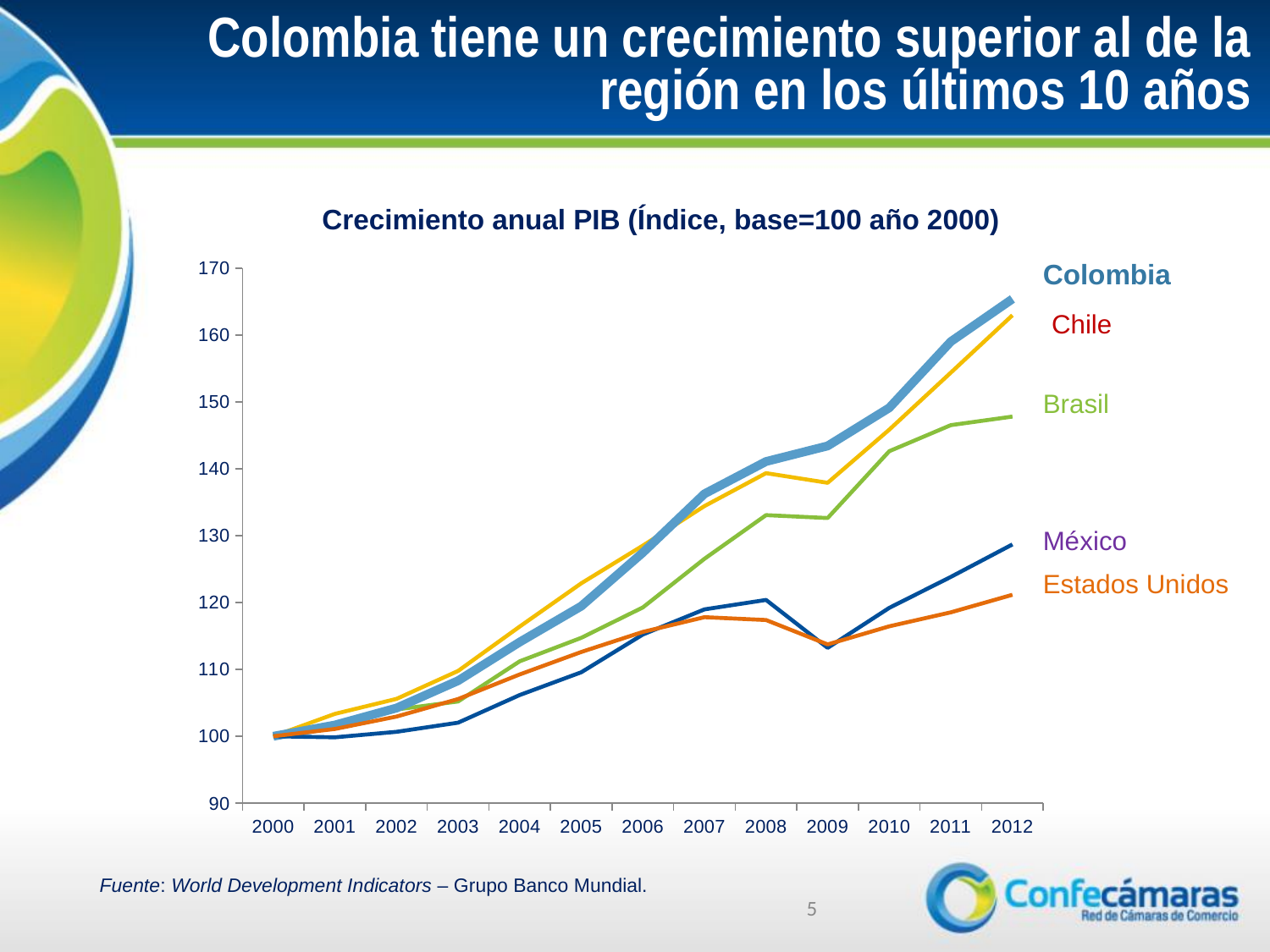
How many years are plotted along the x axis? 13 Is the value for Brasil in 2012 greater or less than 150? less Is the value for México in 2009 greater or less than 120? less Is the value for Colombia in 2012 greater or less than 160? greater Which country has the lowest index value in 2012? Estados Unidos How many series (countries) does the chart show? 5 Does the Colombia line generally rise or fall from 2000 to 2012? rise Which country has the highest index value in 2012? Colombia What is the title of the chart? Crecimiento anual PIB (Índice, base=100 año 2000) What is the index value for Colombia in 2000? 100 What kind of chart is shown on the slide? line chart In 2012, which is larger, the value for Brasil or the value for México? Brasil